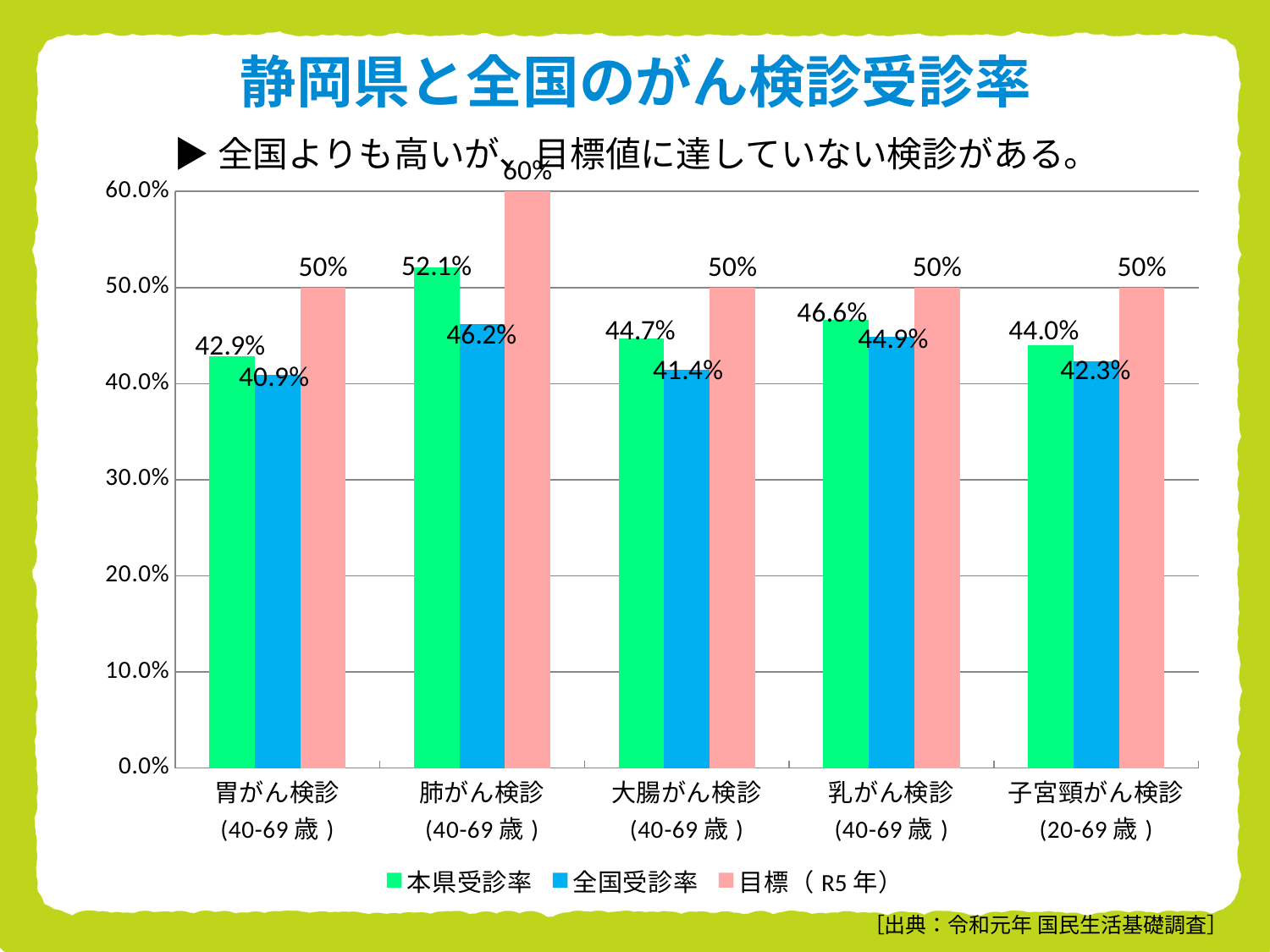
What is the 目標（R5年） value for 肺がん検診? 60% What is the title of the slide? 静岡県と全国のがん検診受診率 Which is larger for 乳がん検診: the 本県受診率 or the 全国受診率? 本県受診率 What is the 全国受診率 value for 子宮頸がん検診? 42.3% What kind of chart is shown on the slide? Bar chart What is the 全国受診率 value for 胃がん検診? 40.9% How many series does the legend list? 3 What is the difference between the 本県受診率 and 全国受診率 for 大腸がん検診? 3.3% How many screening categories are shown on the x axis? 5 Which screening has the highest 本県受診率? 肺がん検診 Which screening has the lowest 全国受診率? 胃がん検診 What is the 本県受診率 value for 肺がん検診? 52.1%